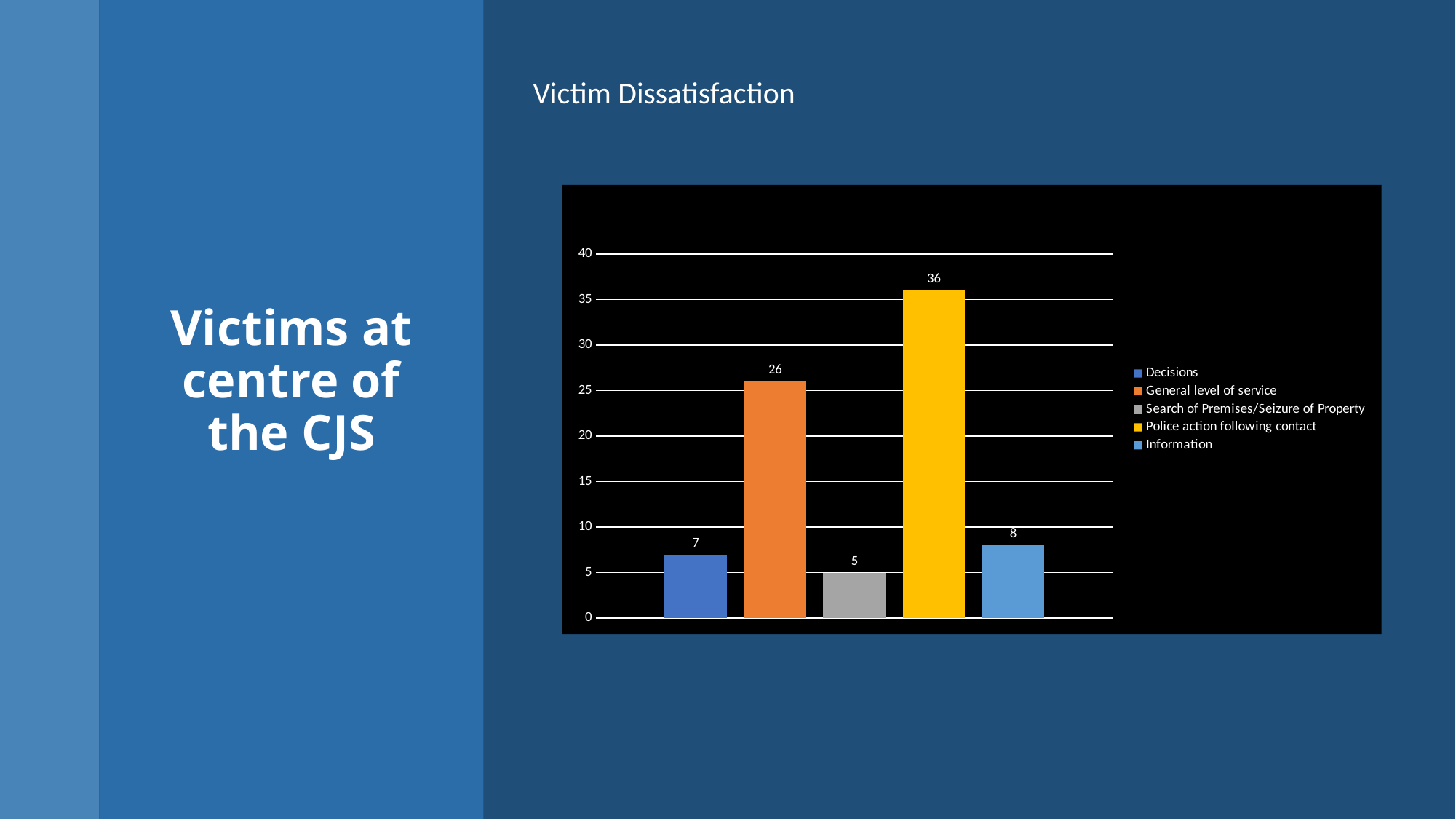
What is the difference between the values for Police action following contact and General level of service? 10 Which category has the highest value? Police action following contact What is the value for Police action following contact? 36 How many bars are plotted in the chart? 5 What is the value for Search of Premises/Seizure of Property? 5 What is the title of the chart? Victim Dissatisfaction What kind of chart is shown on the slide? Bar chart What is the value for Information? 8 Which is larger, the value for Information or the value for Decisions? Information Which category has the lowest value? Search of Premises/Seizure of Property What is the value for General level of service? 26 What is the value for Decisions? 7